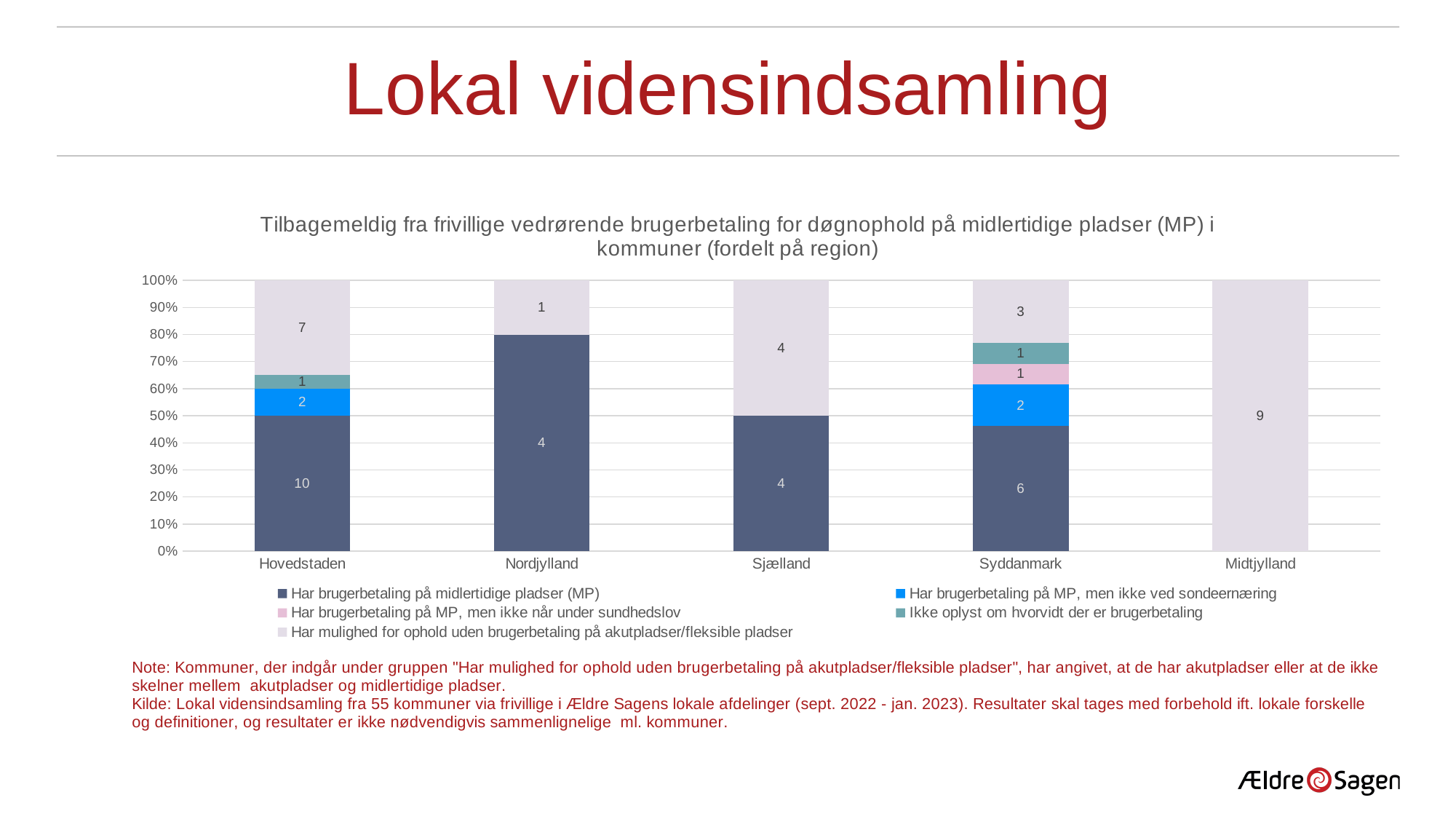
What is the value for 'Har brugerbetaling på MP, men ikke ved sondeernæring' in Syddanmark? 2 What kind of chart is shown on the slide? Stacked bar chart What is the total of all segments in the Syddanmark bar? 13 What is the difference between the 'Har brugerbetaling på midlertidige pladser (MP)' values for Hovedstaden and Syddanmark? 4 What is the total of all segments in the Hovedstaden bar? 20 What is the value for 'Har mulighed for ophold uden brugerbetaling på akutpladser/fleksible pladser' in Nordjylland? 1 How many series does the chart legend list? 5 Which is larger: the 'Har mulighed for ophold uden brugerbetaling på akutpladser/fleksible pladser' value for Sjælland or for Syddanmark? Sjælland How many regions are shown on the x axis of the chart? 5 What is the value for 'Har brugerbetaling på midlertidige pladser (MP)' in Hovedstaden? 10 Which region has the highest value for 'Har brugerbetaling på midlertidige pladser (MP)'? Hovedstaden What is the value for 'Har mulighed for ophold uden brugerbetaling på akutpladser/fleksible pladser' in Midtjylland? 9